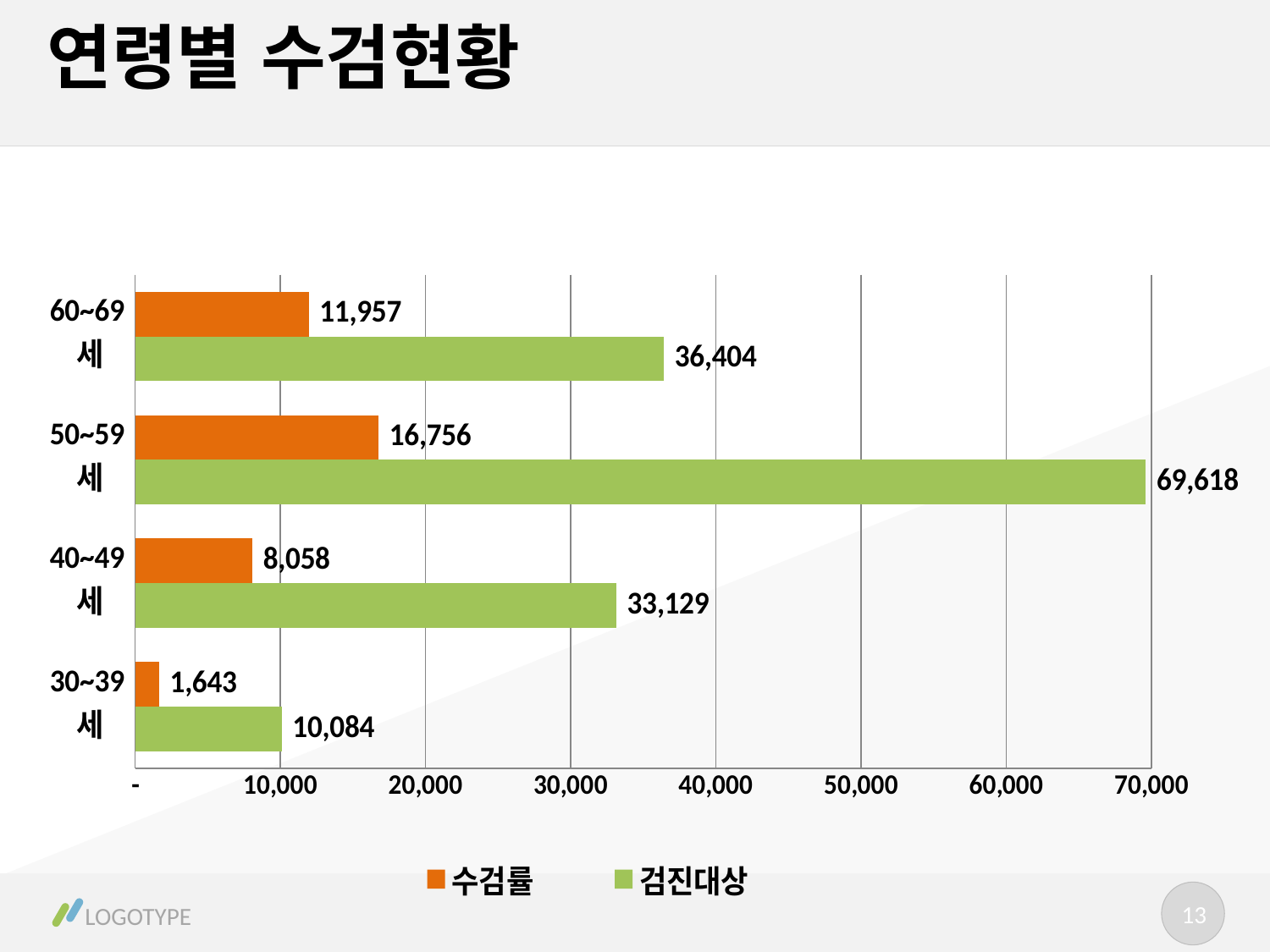
Which age group has the lowest 수검률 value? 30~39세 How many age groups are shown on the chart? 4 How many series does the legend list? 2 Which age group has the highest 검진대상 value? 50~59세 What is the 수검률 value for 60~69세? 11,957 What is the difference between the 검진대상 values for 50~59세 and 40~49세? 36,489 What is the 검진대상 value for 50~59세? 69,618 What is the difference between the 검진대상 and 수검률 values for 50~59세? 52,862 What type of chart is shown on the slide? bar chart Which is larger, the 수검률 value for 60~69세 or for 50~59세? 50~59세 What is the 수검률 value for 30~39세? 1,643 What is the 검진대상 value for 40~49세? 33,129